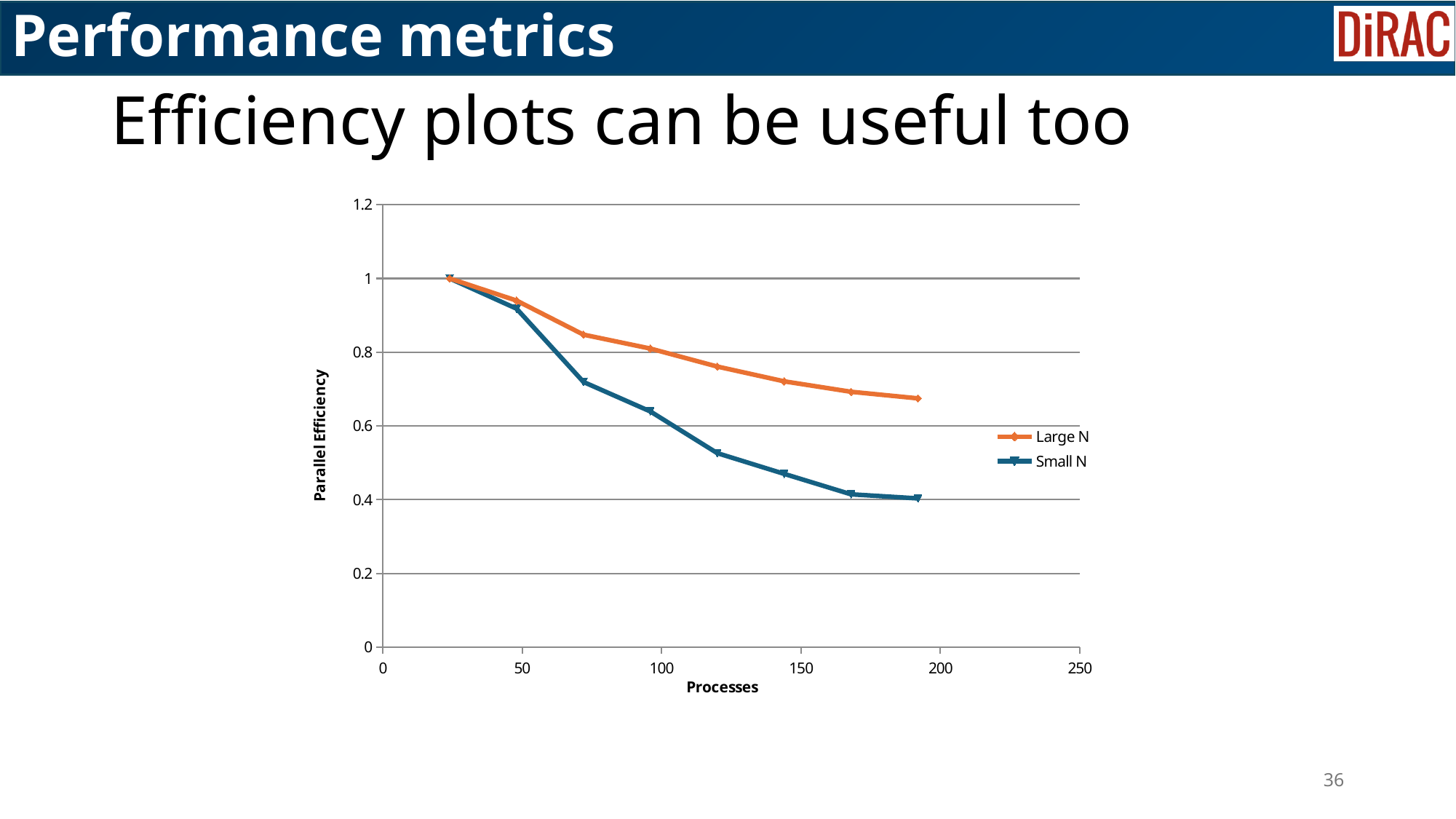
Do the Parallel Efficiency values for Small N rise or fall as the number of processes increases? fall Is the Parallel Efficiency of the last Small N point (near 200 processes) greater or less than 0.6? less Is the Parallel Efficiency of the Small N point nearest 100 processes greater or less than 0.8? less How many data points are plotted for the Small N series? 8 What kind of chart is shown on the slide? line chart Is the Parallel Efficiency of the last Large N point (near 200 processes) greater or less than 0.6? greater At around 150 processes, which series has the higher Parallel Efficiency, Large N or Small N? Large N Which series ends with the lower Parallel Efficiency at its last plotted point? Small N What are the two series named in the legend? Large N and Small N How many series does the legend list? 2 Do the Parallel Efficiency values for Large N rise or fall as the number of processes increases? fall What is the label on the vertical axis of the chart? Parallel Efficiency